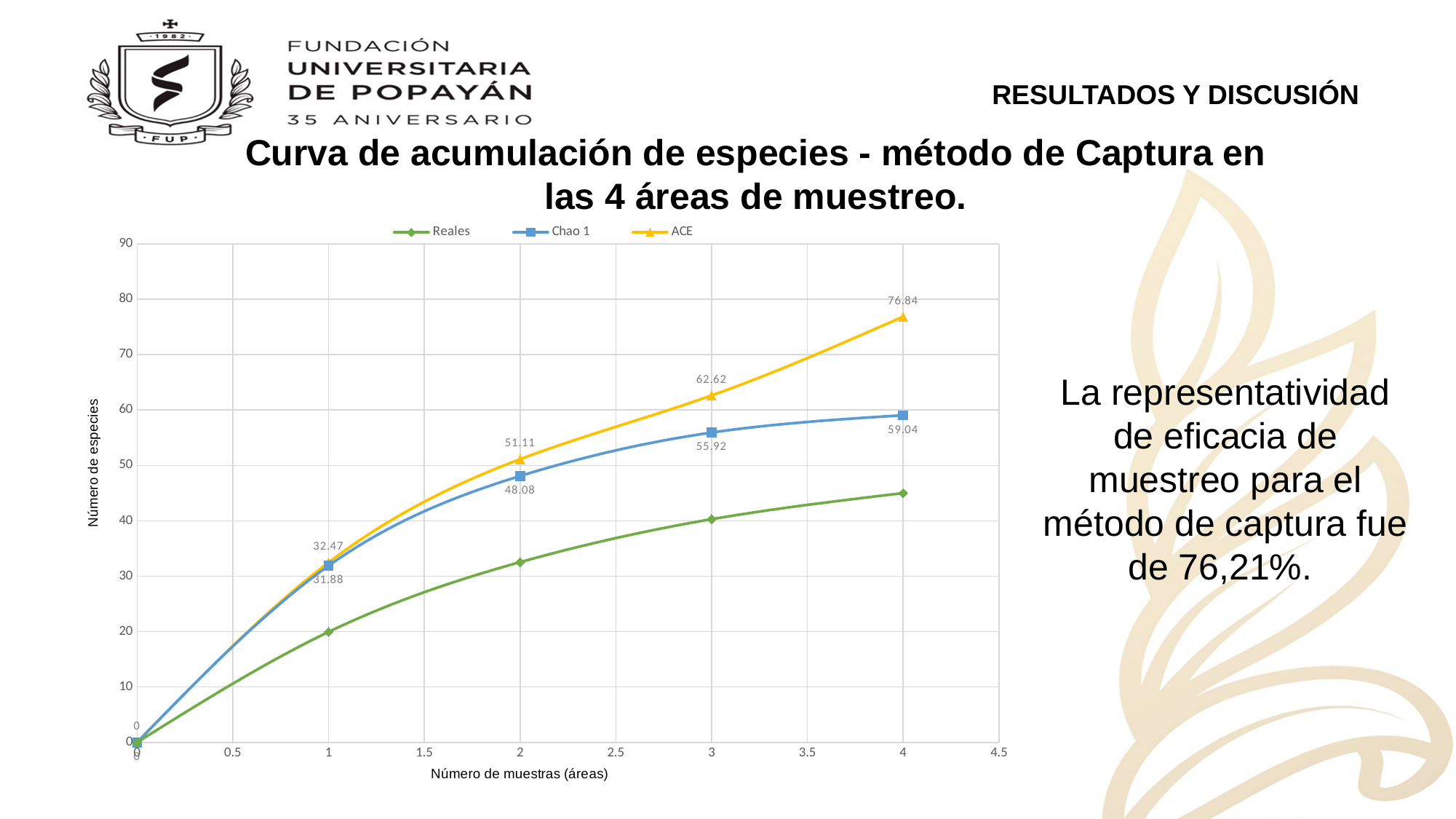
What is the value of the Chao 1 series at 3 samples (áreas)? 55.92 Which series has the lowest value at 3 samples (áreas)? Reales What type of chart is shown on the slide? line chart What is the label of the y axis? Número de especies What is the difference between the ACE and Chao 1 values at 4 samples (áreas)? 17.80 How many series does the legend list? 3 What is the value of the Chao 1 series at 1 sample (área)? 31.88 What is the value of the ACE series at 4 samples (áreas)? 76.84 Do the values of the ACE series rise or fall as the number of samples increases? rise Is the value of the Reales series at 4 samples (áreas) greater or less than 50? less What is the value of the ACE series at 2 samples (áreas)? 51.11 Which series has the highest value at 4 samples (áreas)? ACE